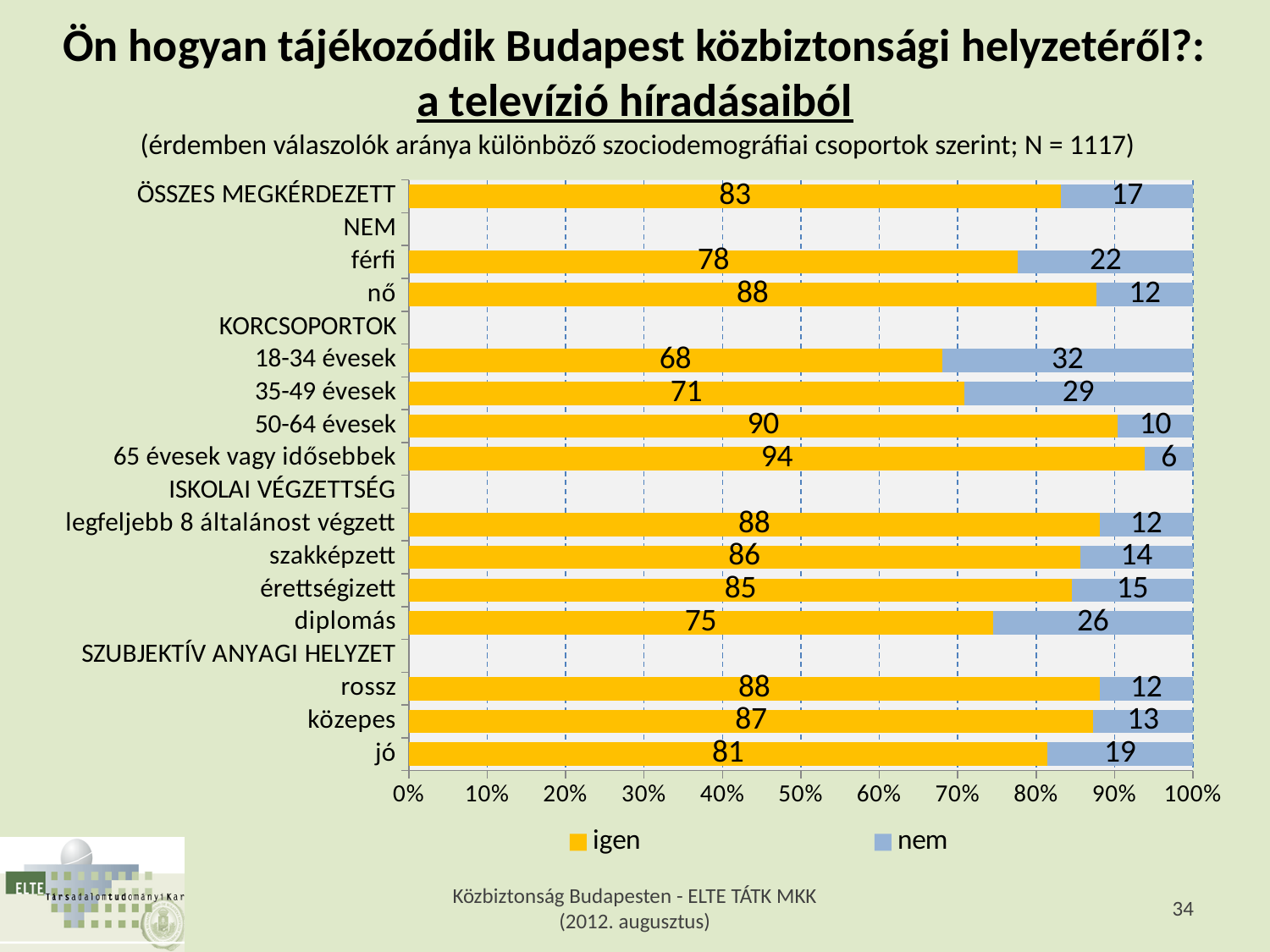
What is the "nem" value for 18-34 évesek? 32 What kind of chart is shown on the slide? stacked bar chart Which has a larger "nem" value, 35-49 évesek or 50-64 évesek? 35-49 évesek Which colour represents the "nem" series? blue What is the "igen" value for ÖSSZES MEGKÉRDEZETT? 83 Is the "igen" value for jó greater or less than 80%? greater What is the "igen" value for diplomás? 75 What is the total of the stacked bar for közepes? 100 Which category has the lowest "igen" value? 18-34 évesek Which category has the highest "igen" value? 65 évesek vagy idősebbek How many series does the legend list? 2 What is the difference between the "igen" values for nő and férfi? 10